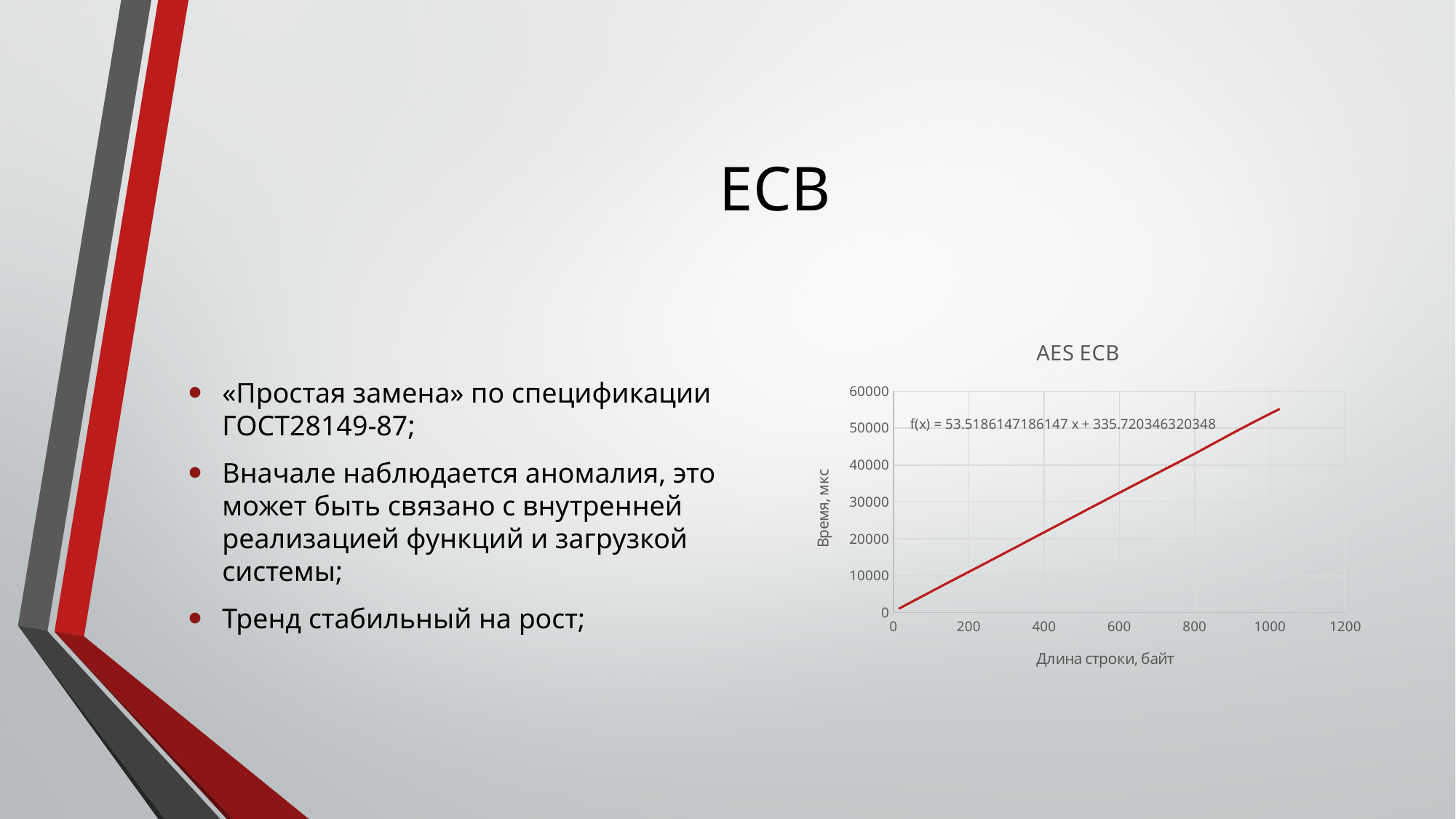
What is the highest tick value shown on the y axis of the chart? 60000 What is the highest tick value shown on the x axis of the chart? 1200 What is the label of the x axis of the chart? Длина строки, байт Does the plotted line rise or fall as the string length increases along the x axis? rise Is the value for a string length of 400 bytes greater or less than 30000? less Is the value for a string length of 1000 bytes greater or less than 50000? greater What is the title of the chart? AES ECB Is the value for a string length of 600 bytes greater or less than 20000? greater What kind of chart is shown on the slide? line chart